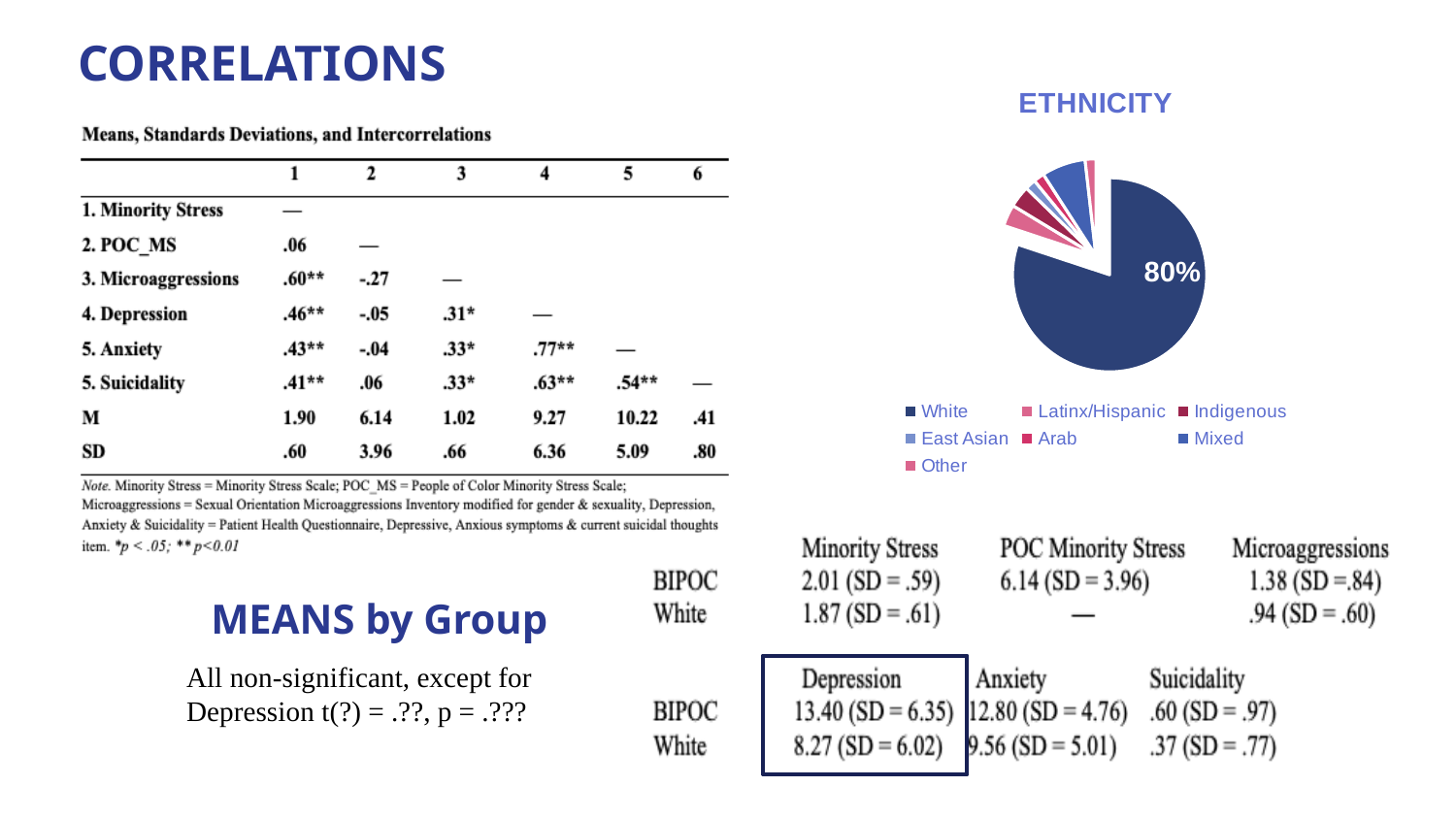
In the ETHNICITY pie chart, which is larger: the Mixed slice or the White slice? White What kind of chart is the ETHNICITY chart? pie chart How many categories does the legend of the ETHNICITY pie chart list? 7 In the ETHNICITY pie chart, which is larger: the White slice or the Latinx/Hispanic slice? White Is the White slice in the ETHNICITY pie chart more or less than half of the pie? more Which category has the largest slice in the ETHNICITY pie chart? White In the ETHNICITY pie chart, what share of the pie does White represent? 80% What colour is the White slice in the ETHNICITY pie chart? dark blue In the ETHNICITY pie chart, what is the value shown for the White slice? 80% What is the title of the pie chart on the slide? ETHNICITY